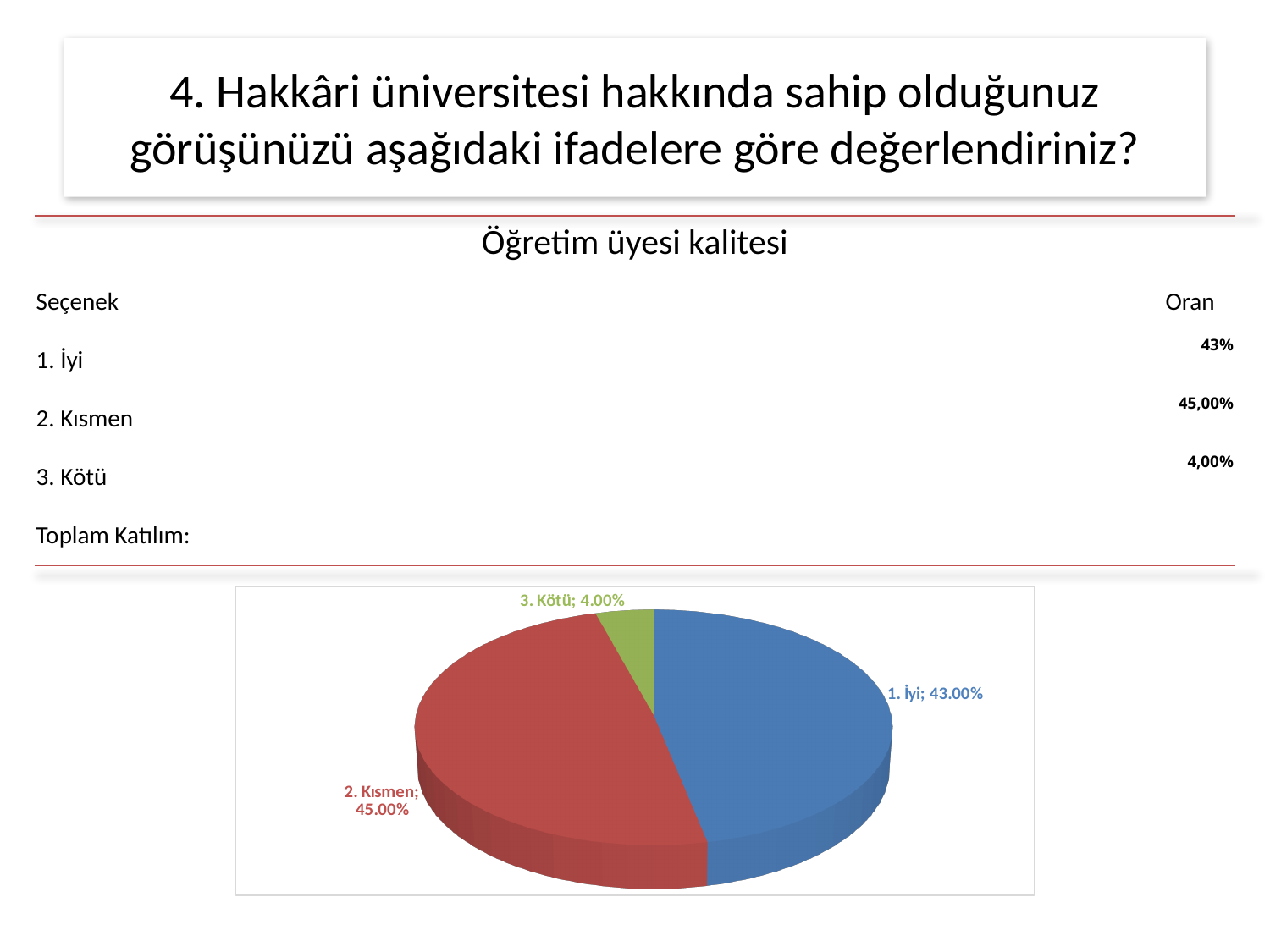
Which slice of the pie chart has the smallest value? 3. Kötü What is the value shown for the slice labelled "3. Kötü" in the pie chart? 4.00% What is the difference between the values for "2. Kısmen" and "1. İyi" in the pie chart? 2.00% What kind of chart is shown on the slide? Pie chart Which slice of the pie chart has the largest value? 2. Kısmen How many slices does the pie chart have? 3 What is the value shown for the slice labelled "2. Kısmen" in the pie chart? 45.00% What is the difference between the values for "1. İyi" and "3. Kötü" in the pie chart? 39.00% What share of the pie does the "3. Kötü" slice represent according to its label? 4.00% Which is larger in the pie chart, the value for "1. İyi" or the value for "3. Kötü"? 1. İyi What is the value shown for the slice labelled "1. İyi" in the pie chart? 43.00% What colour is the "2. Kısmen" slice in the pie chart? Red